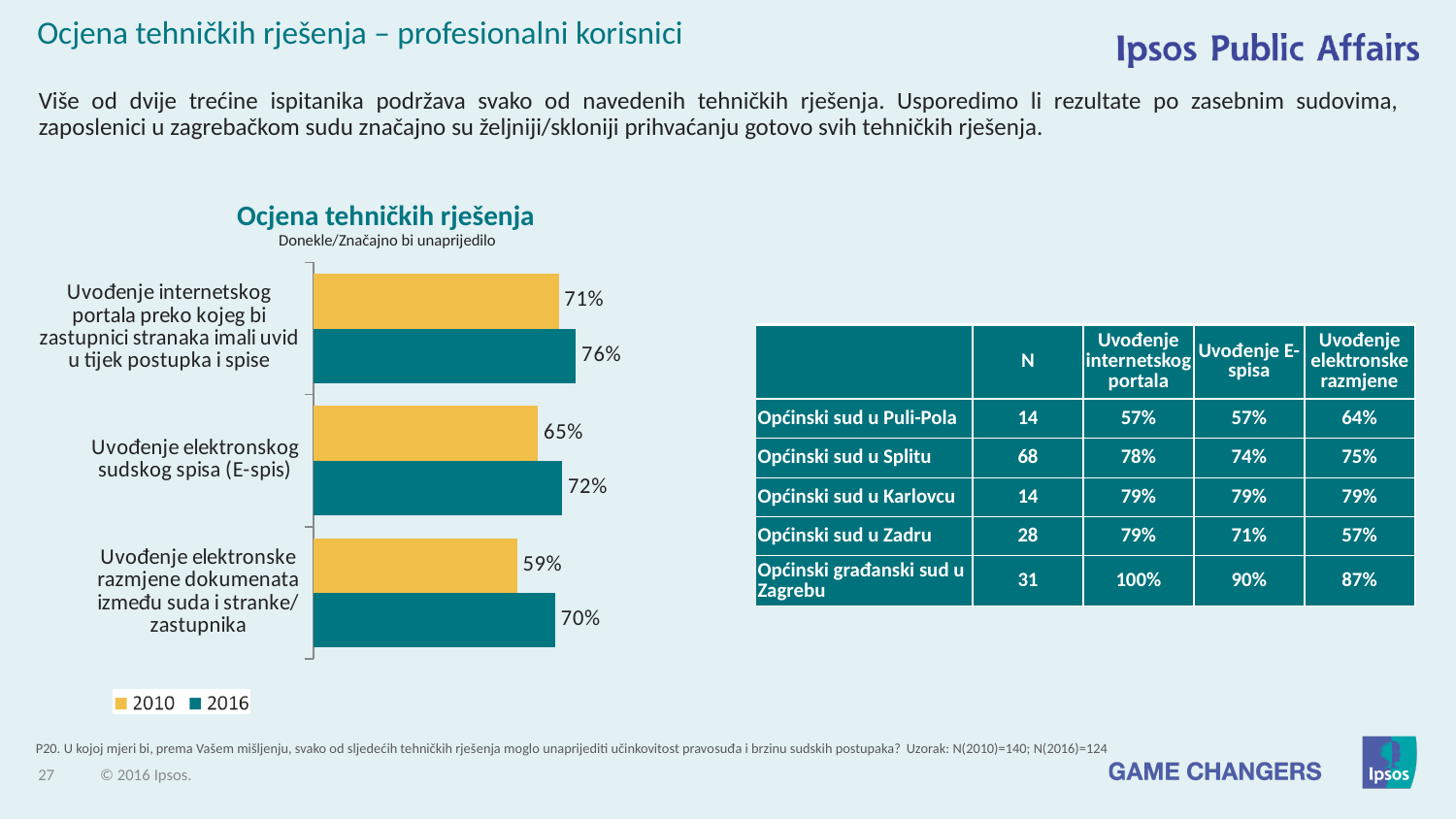
What is the difference between the 2016 and 2010 values for 'Uvođenje elektronskog sudskog spisa (E-spis)'? 7% What is the difference between the 2016 and 2010 values for 'Uvođenje elektronske razmjene dokumenata između suda i stranke/zastupnika'? 11% What is the 2016 value for 'Uvođenje elektronske razmjene dokumenata između suda i stranke/zastupnika'? 70% What is the 2010 value for 'Uvođenje elektronske razmjene dokumenata između suda i stranke/zastupnika'? 59% Which category has the lowest 2010 value? Uvođenje elektronske razmjene dokumenata između suda i stranke/zastupnika What type of chart is shown on the slide? bar chart How many categories are shown in the chart? 3 What is the 2016 value for 'Uvođenje internetskog portala preko kojeg bi zastupnici stranaka imali uvid u tijek postupka i spise'? 76% Which category has the highest 2016 value? Uvođenje internetskog portala preko kojeg bi zastupnici stranaka imali uvid u tijek postupka i spise Which is larger for 'Uvođenje internetskog portala', the 2010 value or the 2016 value? 2016 How many series does the chart legend list? 2 What is the 2010 value for 'Uvođenje elektronskog sudskog spisa (E-spis)'? 65%